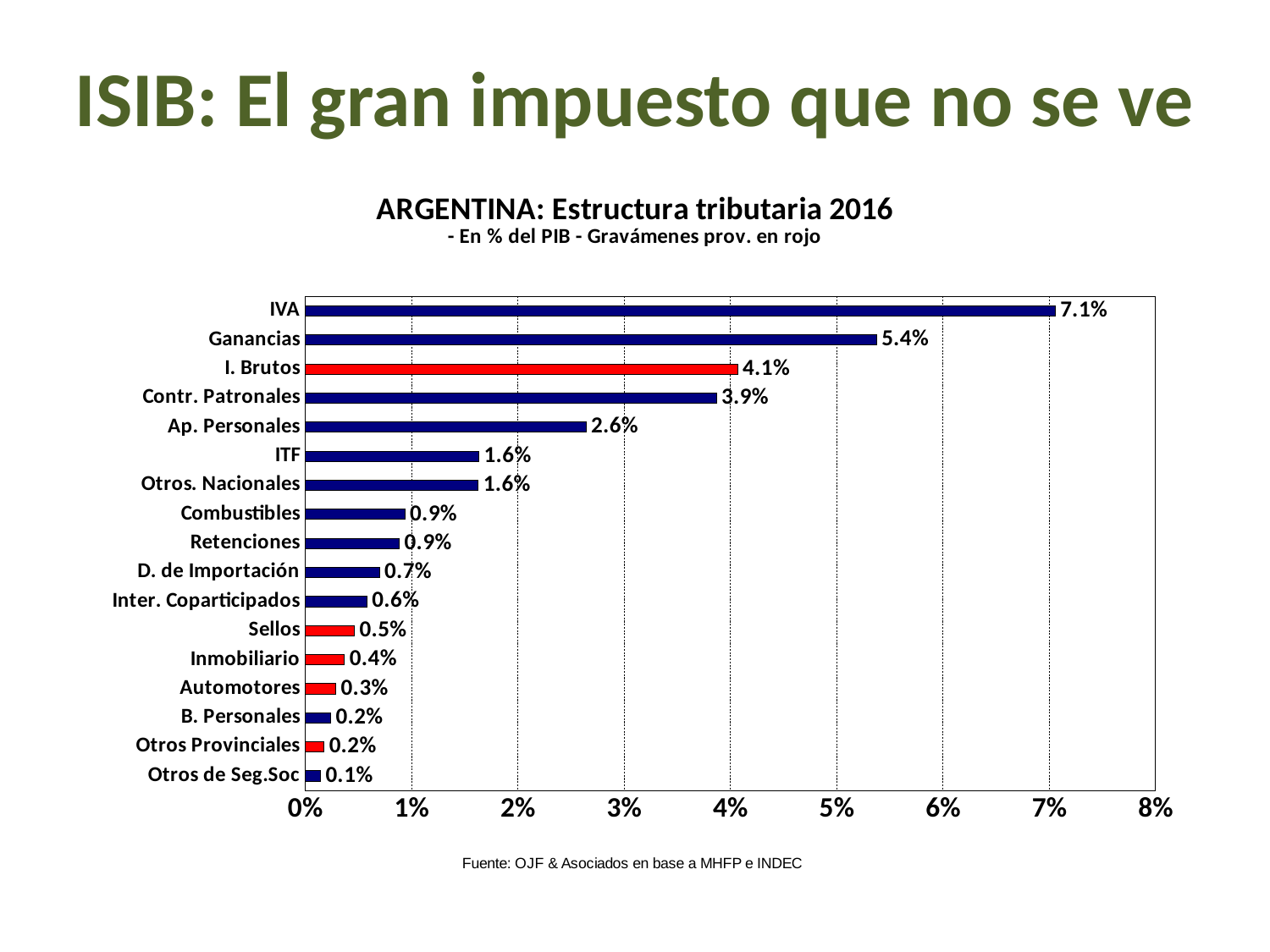
What kind of chart is shown on the slide? bar chart What is the difference between the values for I. Brutos and Contr. Patronales? 0.2% What is the title of the chart? ARGENTINA: Estructura tributaria 2016 What is the value for I. Brutos? 4.1% Which is larger, the value for Ganancias or the value for Contr. Patronales? Ganancias What is the value for Ap. Personales? 2.6% Is the value for Ap. Personales greater or less than 3%? less Which category has the lowest value? Otros de Seg.Soc What is the value for IVA? 7.1% How many categories are shown in the chart? 17 What is the difference between the values for IVA and Ganancias? 1.7% Which category has the highest value? IVA